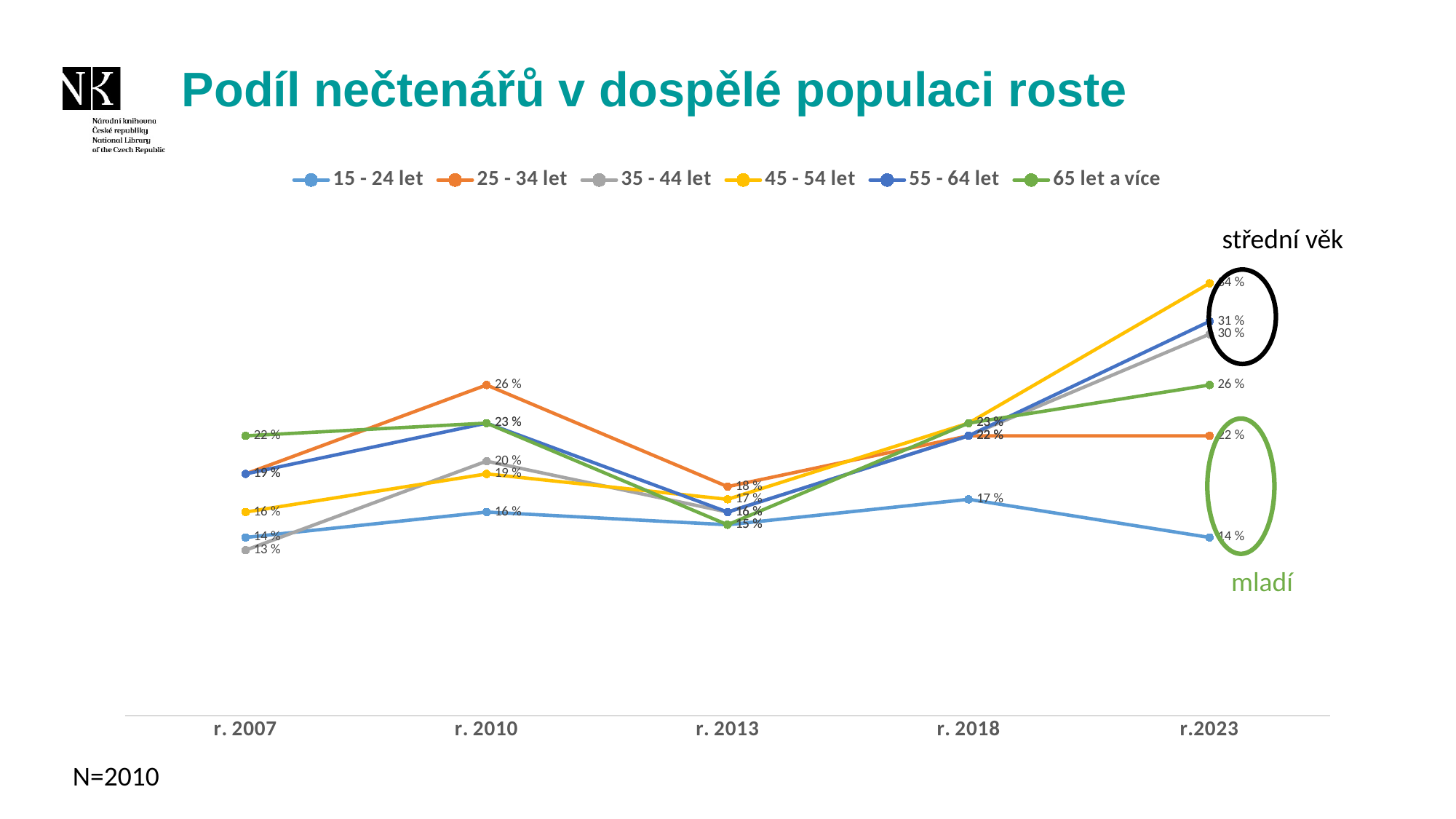
What type of chart is shown on the slide? line chart In r.2023, which is larger: the value for 65 let a více or for 25 - 34 let? 65 let a více What is the difference between the 45 - 54 let and 15 - 24 let values in r.2023? 20 percentage points What is the value for the 15 - 24 let series in r.2023? 14 % Does the 15 - 24 let series rise or fall from r. 2018 to r.2023? fall Which age group has the highest value in r.2023? 45 - 54 let What is the value for the 45 - 54 let series in r.2023? 34 % What is the value for the 25 - 34 let series in r. 2010? 26 % How many series does the legend list? 6 How many years are shown on the x axis? 5 Which age group has the lowest value in r.2023? 15 - 24 let What is the value for the 65 let a více series in r. 2007? 22 %